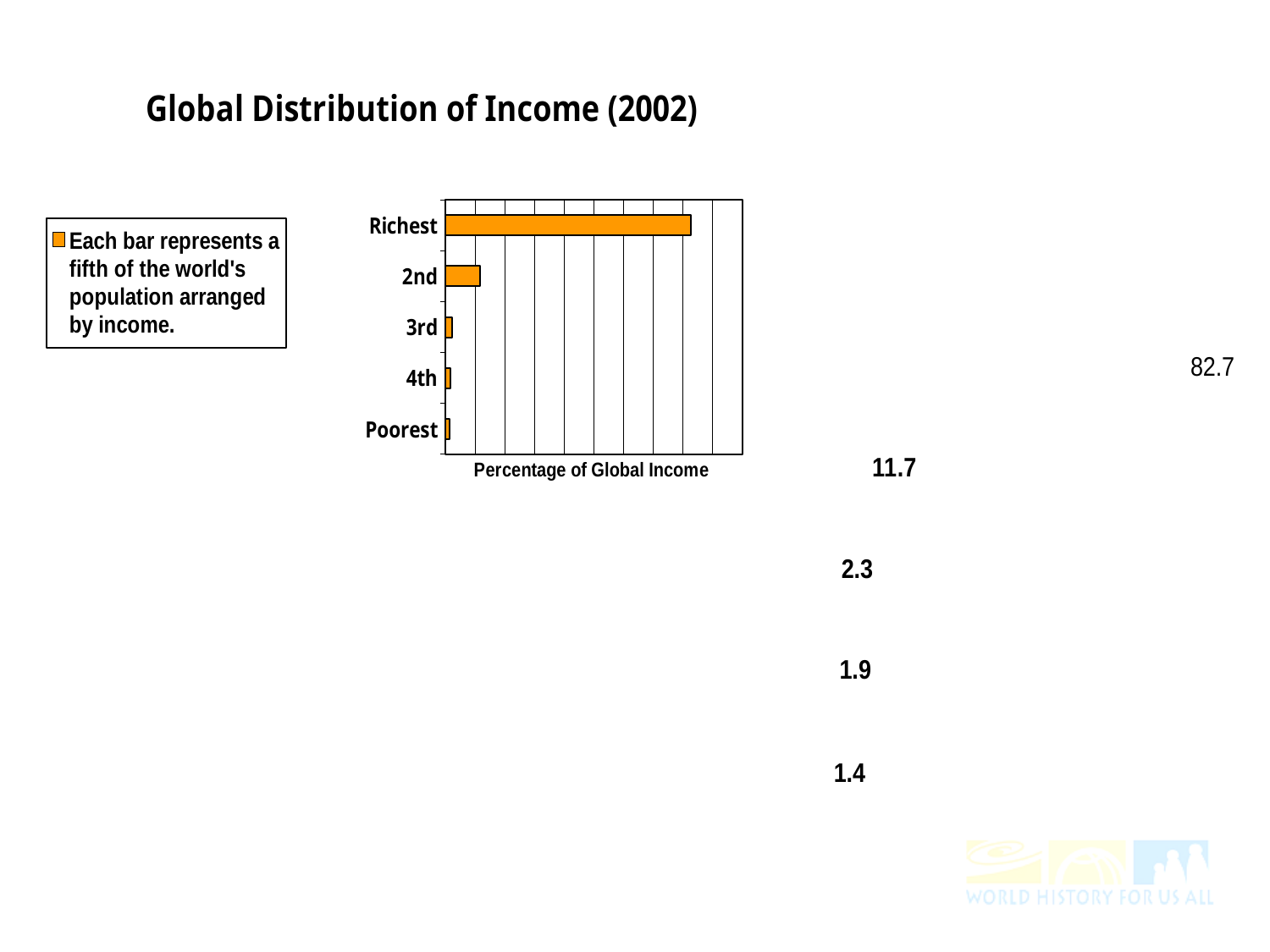
Which has a larger share of global income, the 2nd fifth or the 3rd fifth? 2nd How many categories (bars) does the chart show? 5 What is the label on the horizontal axis of the chart? Percentage of Global Income What is the title of the chart? Global Distribution of Income (2002) What is the value shown for the Richest fifth? 82.7 What kind of chart is shown on the slide? bar chart What is the value shown for the 2nd fifth? 11.7 Which category has the highest percentage of global income? Richest Do the values rise or fall going from the Richest bar down to the Poorest bar? fall What is the value shown for the Poorest fifth? 1.4 Which category has the lowest percentage of global income? Poorest How many series does the legend list? 1